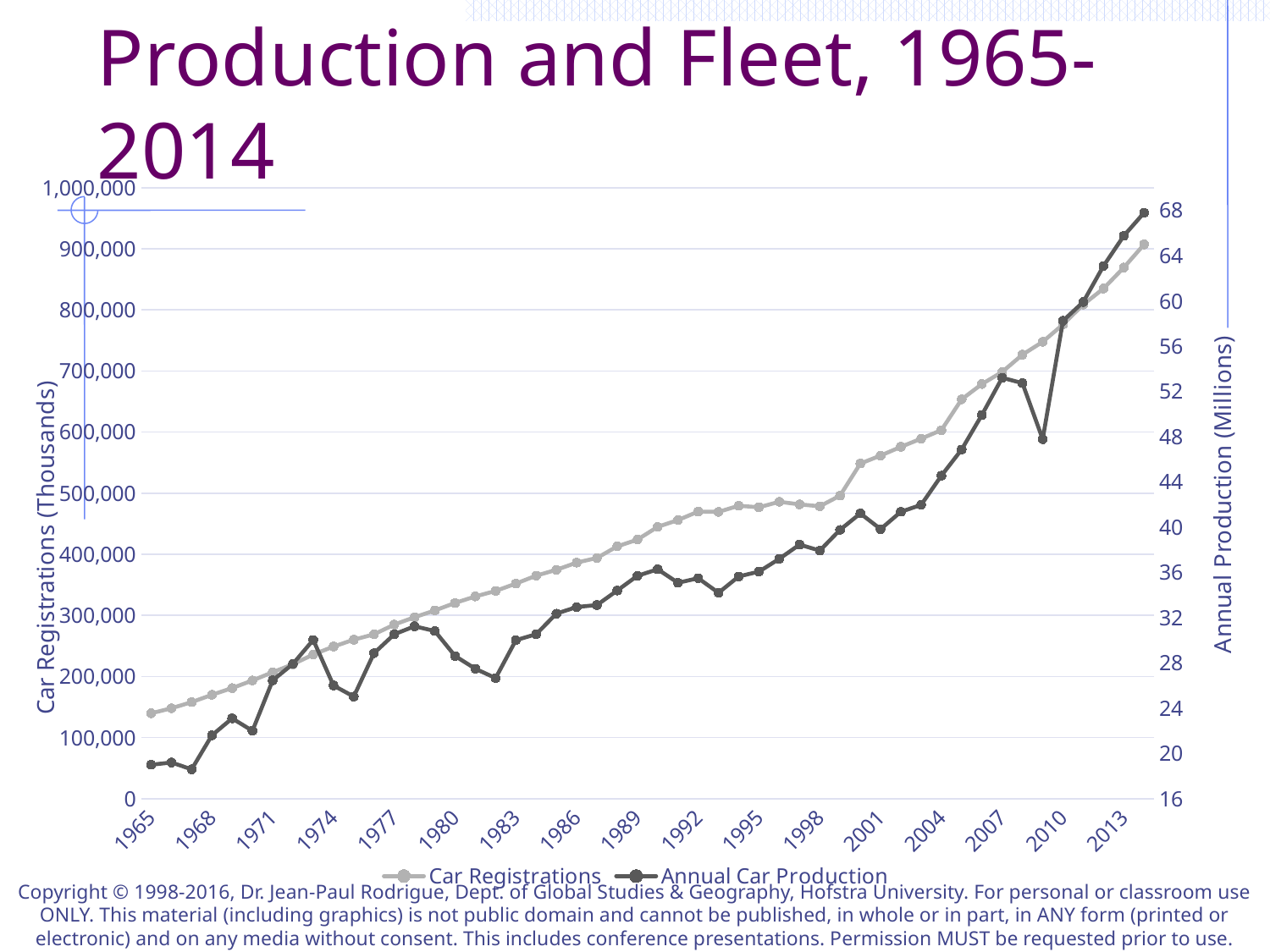
Is the value for Car Registrations in 1965 greater or less than 200,000? less Is the value for Annual Car Production in 1965 greater or less than 20? less What is the label of the right-hand vertical axis? Annual Production (Millions) Is the value for Annual Car Production in 2014 greater or less than 64? greater What kind of chart is shown on the slide? Line chart How many series does the legend list? 2 Do Car Registrations generally rise or fall from 1965 to 2014? Rise In which year are Car Registrations highest? 2014 What are the two series named in the legend? Car Registrations and Annual Car Production In which year are Car Registrations lowest? 1965 In which year is Annual Car Production highest? 2014